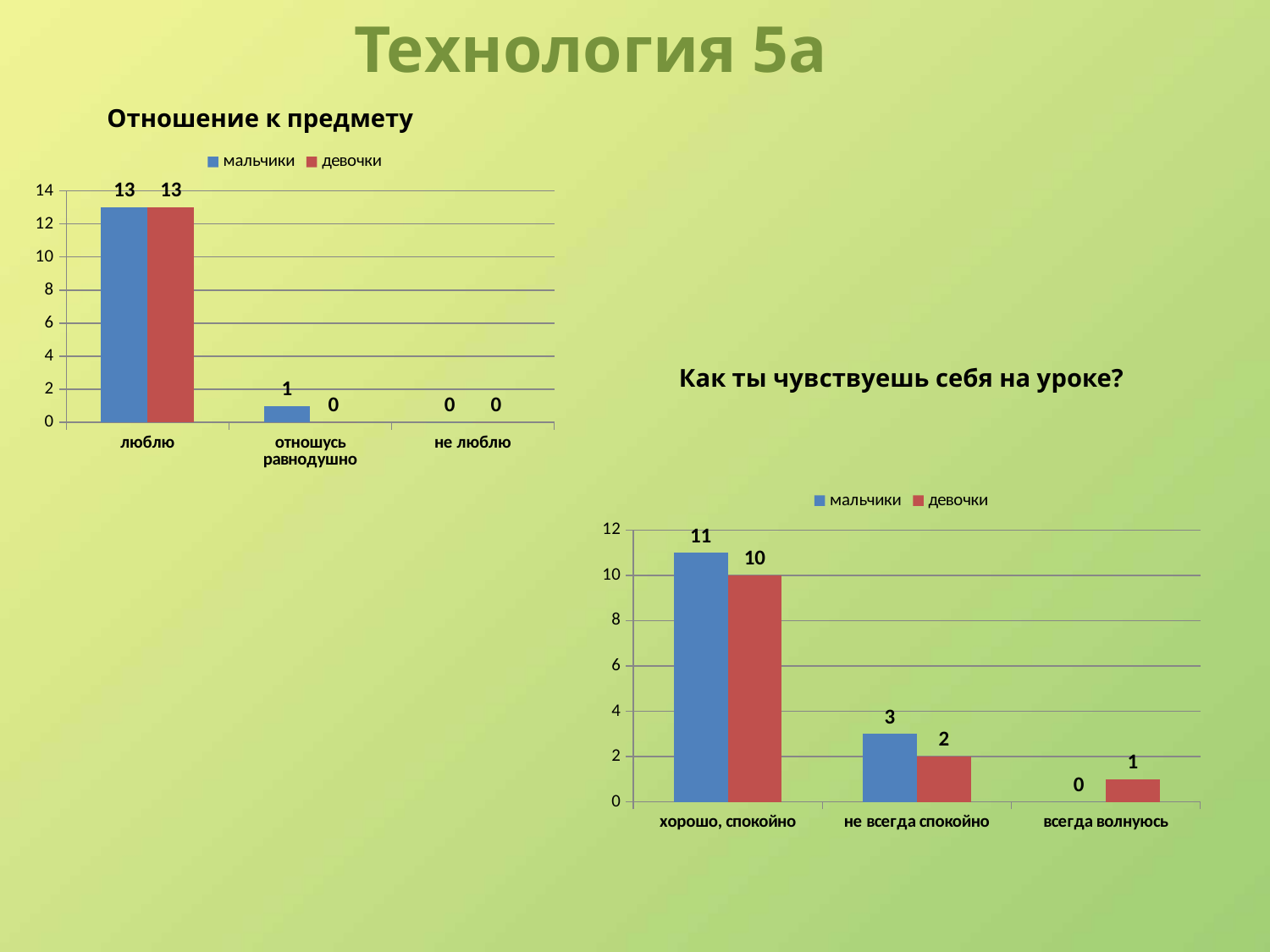
In the chart 'Отношение к предмету', how many categories are shown on the x axis? 3 In the chart 'Отношение к предмету', what is the value for девочки in the category 'отношусь равнодушно'? 0 In the chart 'Как ты чувствуешь себя на уроке?', which category has the lowest value for девочки? всегда волнуюсь In the chart 'Отношение к предмету', what is the difference between the мальчики and девочки values for 'отношусь равнодушно'? 1 How many series does the legend of the chart 'Как ты чувствуешь себя на уроке?' list? 2 In the chart 'Как ты чувствуешь себя на уроке?', which is larger for 'не всегда спокойно': мальчики or девочки? мальчики What kind of chart is 'Отношение к предмету'? bar chart In the chart 'Отношение к предмету', which category has the highest value for мальчики? люблю In the chart 'Отношение к предмету', what is the value for мальчики in the category 'люблю'? 13 In the chart 'Как ты чувствуешь себя на уроке?', what is the difference between мальчики and девочки for 'хорошо, спокойно'? 1 In the chart 'Как ты чувствуешь себя на уроке?', what is the value for девочки in the category 'хорошо, спокойно'? 10 In the chart 'Как ты чувствуешь себя на уроке?', what is the value for мальчики in the category 'всегда волнуюсь'? 0